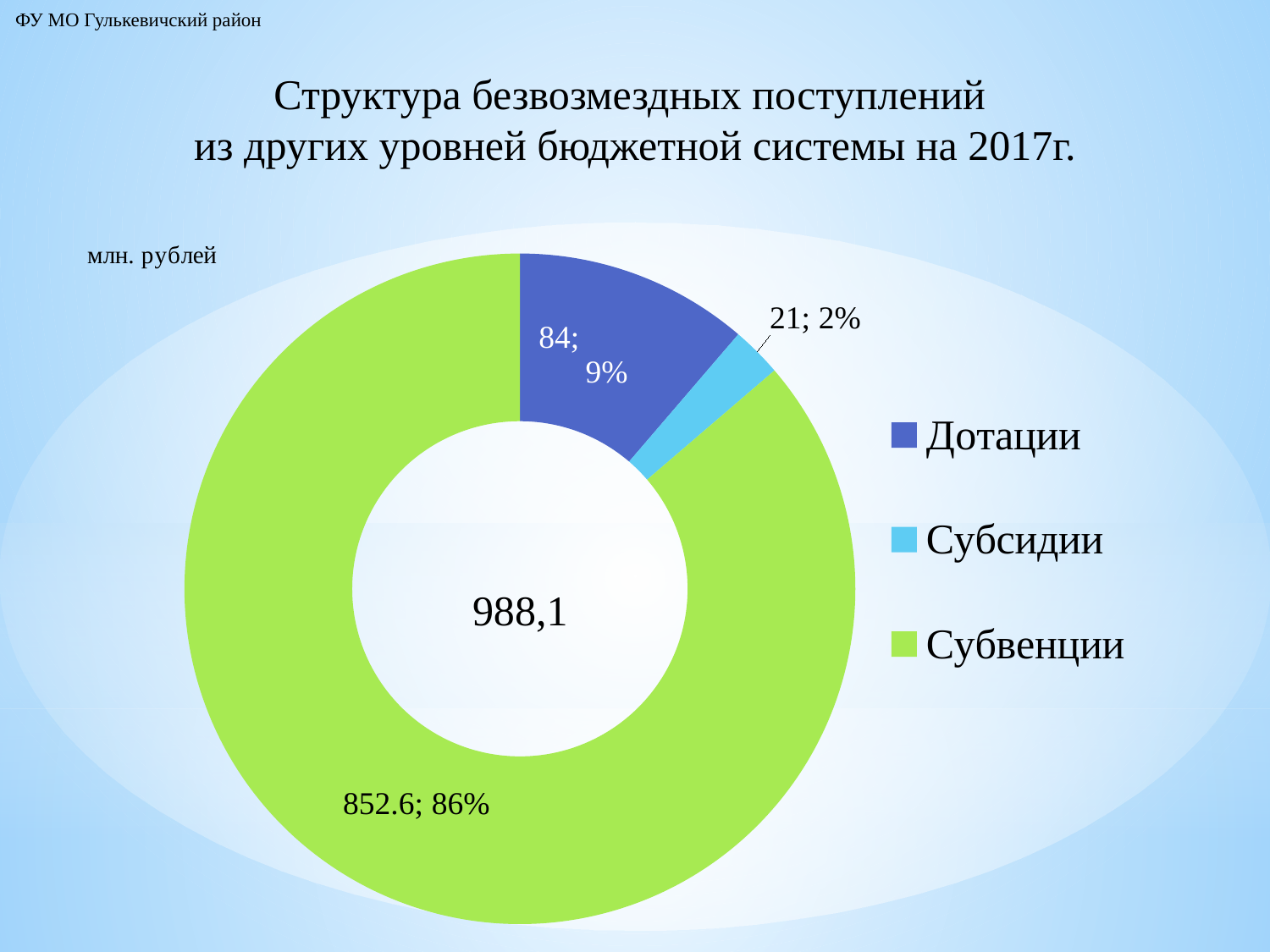
What share of the chart does Субвенции account for? 86% How many categories does the chart show? 3 Which category has the smallest slice? Субсидии Which is larger, Дотации or Субсидии? Дотации What value is shown for Дотации? 84 What is the difference between the values for Дотации and Субсидии? 63 What value is shown for Субвенции? 852.6 Which category has the largest slice? Субвенции What share of the chart does Дотации account for? 9% What value is shown for Субсидии? 21 What kind of chart is shown on the slide? doughnut chart What is the difference between the values for Субвенции and Дотации? 768.6